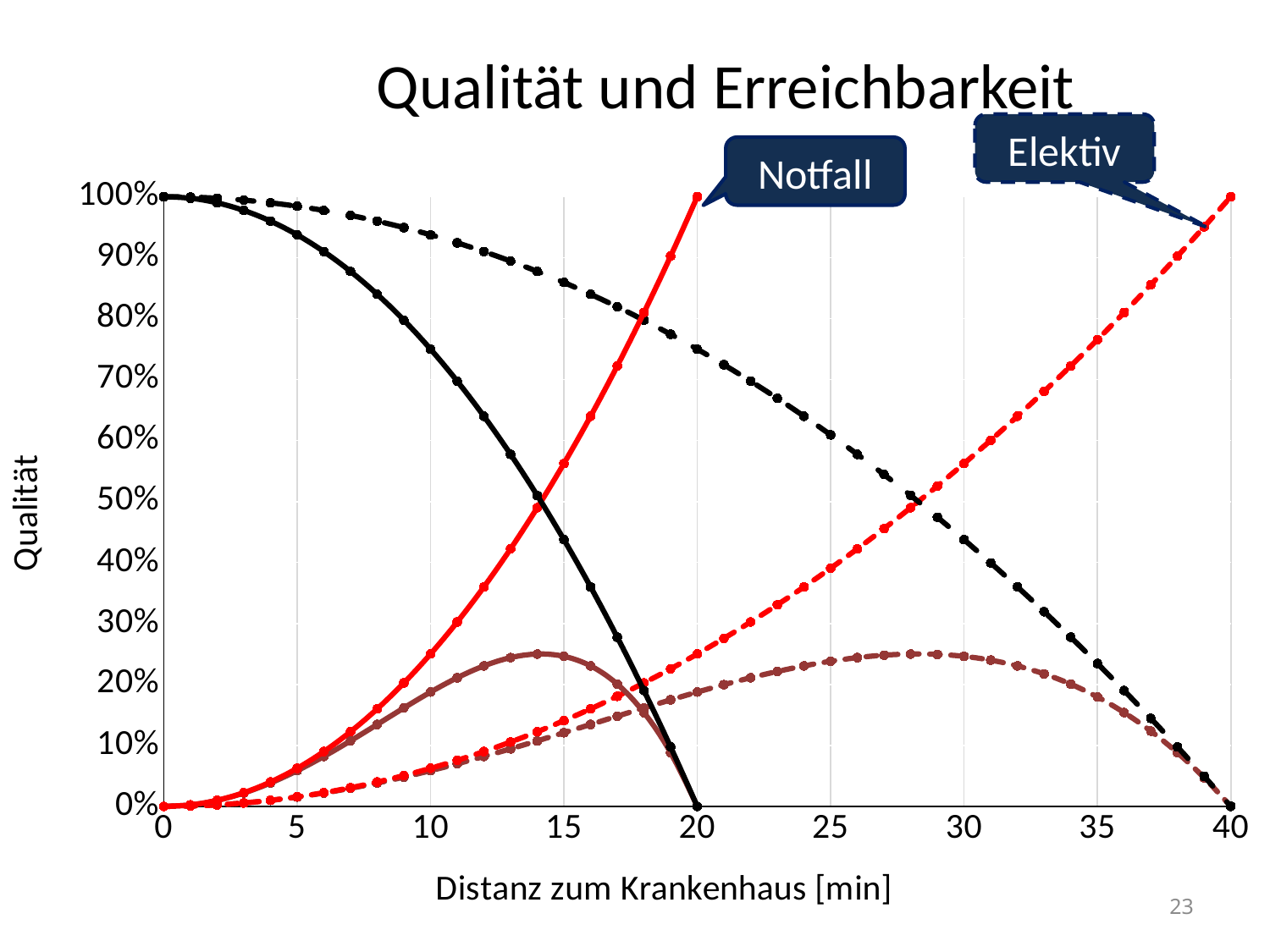
Does the solid black line rise or fall as the distance increases? fall What is the value of the dashed red line at 40 min? 100% At what distance does the dashed black line reach 0%? 40 What is the value of the solid black line at 0 min? 100% Which callout label points to the solid red line that reaches 100% at 20 min? Notfall What kind of chart is shown on the slide? line chart At 10 min, which is larger: the solid black line or the solid red line? solid black line Is the peak value of the solid brown line greater or less than 30%? less What is the value of the solid red line at 20 min? 100% What is the title of the chart? Qualität und Erreichbarkeit Does the dashed red line rise or fall as the distance increases? rise What is the value of the solid black line at 20 min? 0%